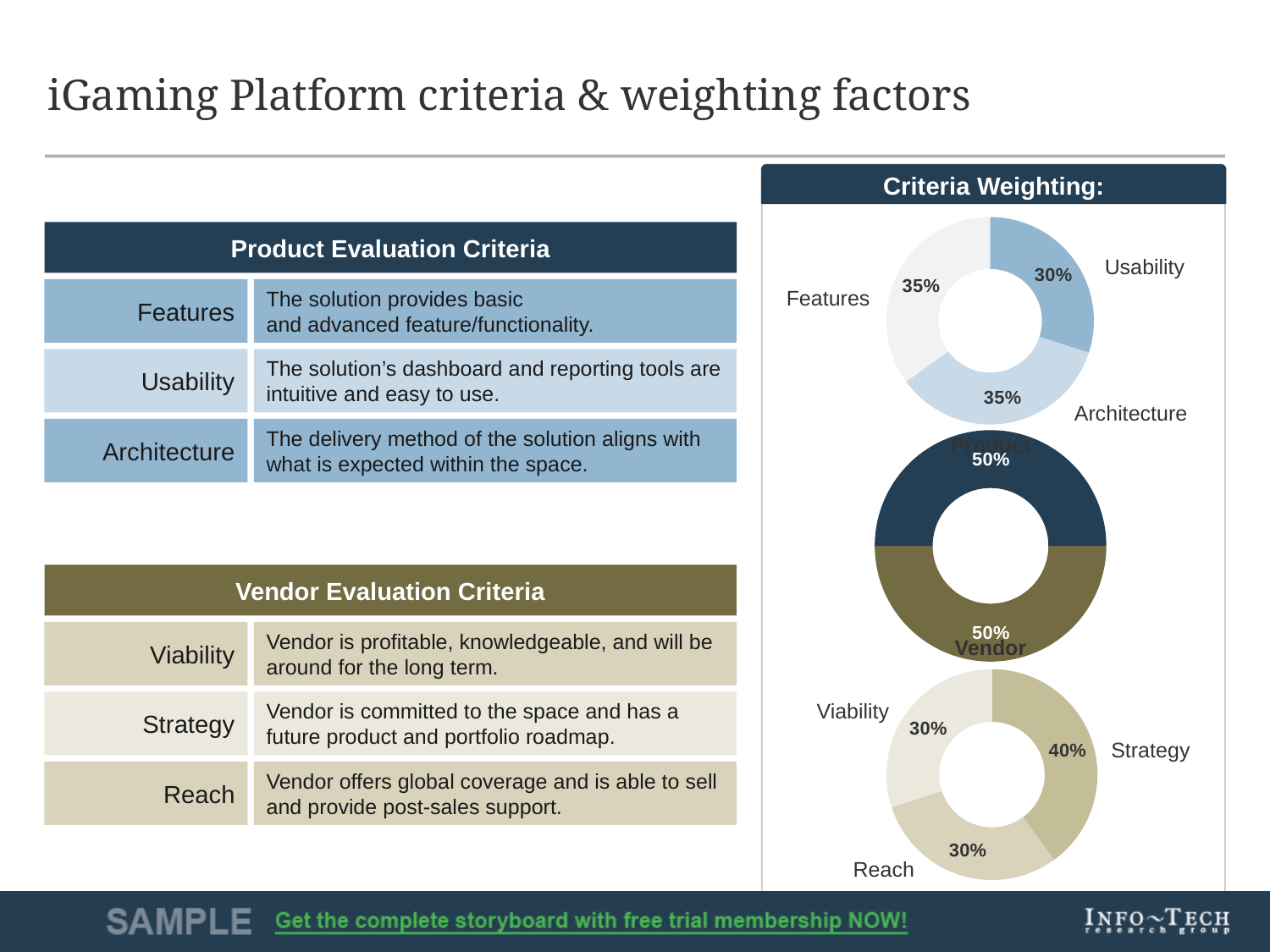
In the top donut chart, how many slices are there? 3 In the middle donut chart, how many slices are there? 2 In the bottom donut chart, what is the difference between the Strategy and Viability weightings? 10% In the bottom donut chart, which criterion has the highest weighting? Strategy In the top donut chart, what is the weighting for Usability? 30% In the bottom donut chart, what is the weighting for Reach? 30% What type of chart is used to show the criteria weightings? Donut chart In the middle donut chart, what is the weighting for Vendor? 50% In the top donut chart, what is the weighting for Features? 35% In the top donut chart, is the weighting for Architecture larger or smaller than the weighting for Usability? larger In the bottom donut chart, what is the weighting for Strategy? 40% In the top donut chart, which criterion has the lowest weighting? Usability